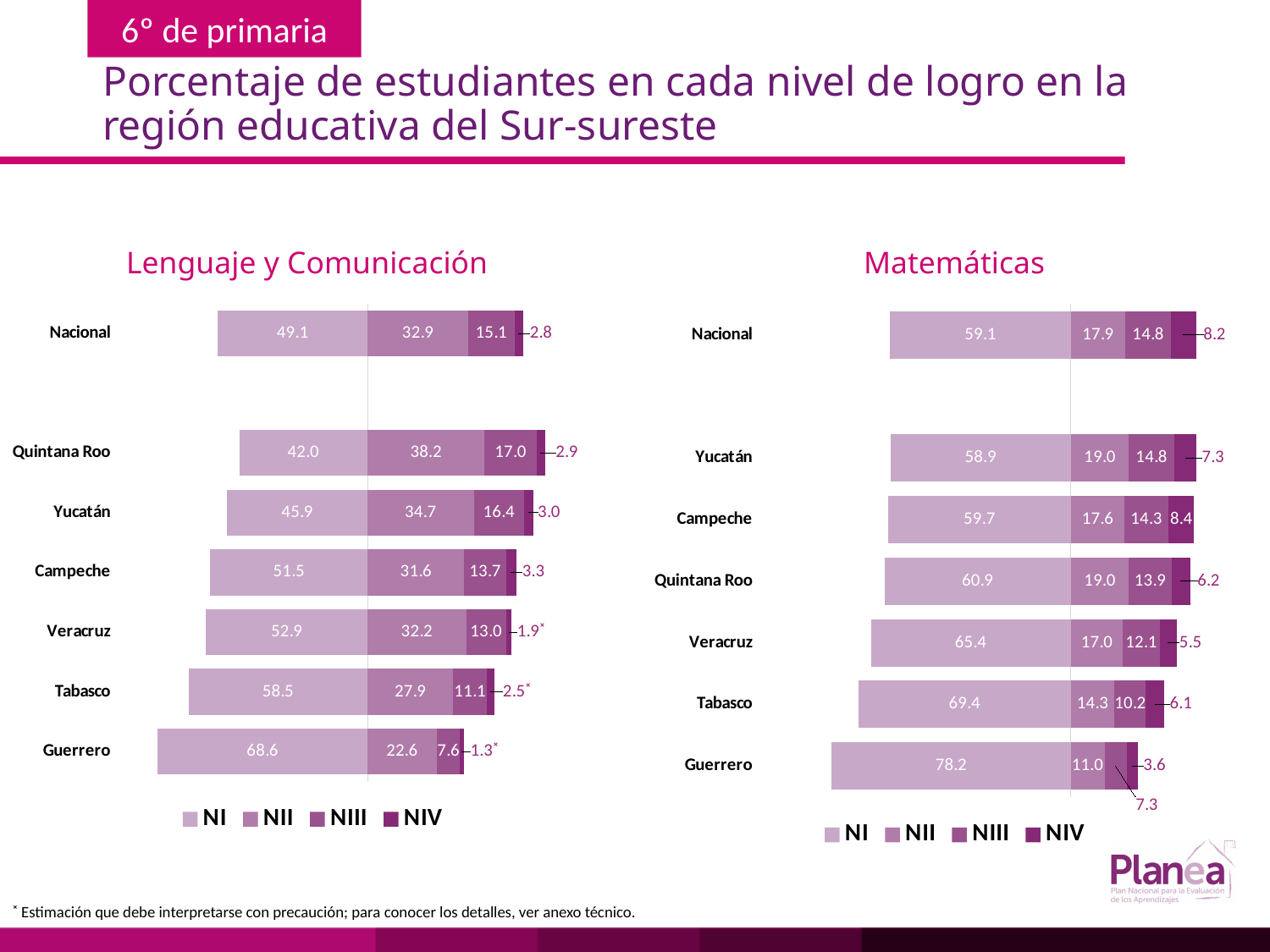
In the Matemáticas chart, what is the NIV value for Campeche? 8.4 In the Matemáticas chart, which state has the highest NI value? Guerrero In the Lenguaje y Comunicación chart, which is larger: the NII value for Quintana Roo or the NII value for Yucatán? Quintana Roo In the Matemáticas chart, what is the difference between the NI values of Guerrero and Nacional? 19.1 How many categories (bars) are shown in the Matemáticas chart? 7 What type of chart is the Matemáticas chart? Stacked bar chart How many series does the legend of the Lenguaje y Comunicación chart list? 4 In the Lenguaje y Comunicación chart, which category has the lowest NIII value? Guerrero In the Lenguaje y Comunicación chart, what is the NIV value for Campeche? 3.3 In the Lenguaje y Comunicación chart, what is the NI value for Guerrero? 68.6 In the Matemáticas chart, what is the NII value for Tabasco? 14.3 What are the legend entries of the Matemáticas chart? NI, NII, NIII, NIV